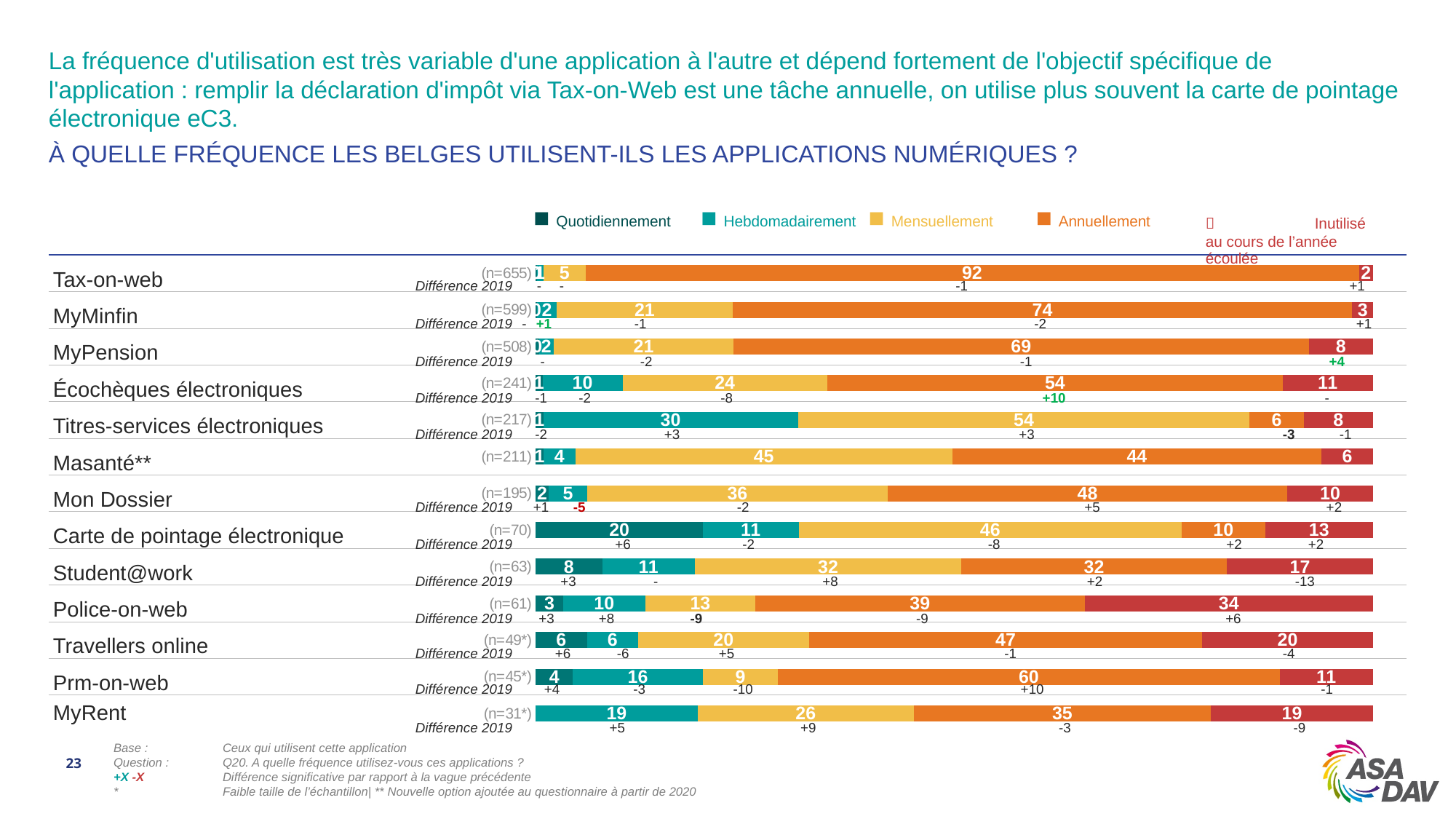
How many series does the legend list? 5 Which has the larger Mensuellement value, Titres-services électroniques or Masanté**? Titres-services électroniques How many applications are shown in the chart? 13 Which application has the highest 'Inutilisé au cours de l'année écoulée' value? Police-on-web What is the difference between the Annuellement values for Prm-on-web and Travellers online? 13 What is the sample size (n) shown for Tax-on-web? n=655 Which application has the highest Annuellement value? Tax-on-web What is the Annuellement value for Tax-on-web? 92 What is the Hebdomadairement value for Titres-services électroniques? 30 What is the 'Inutilisé au cours de l'année écoulée' value for Police-on-web? 34 What kind of chart is shown on the slide? Stacked bar chart What is the Quotidiennement value for Carte de pointage électronique? 20